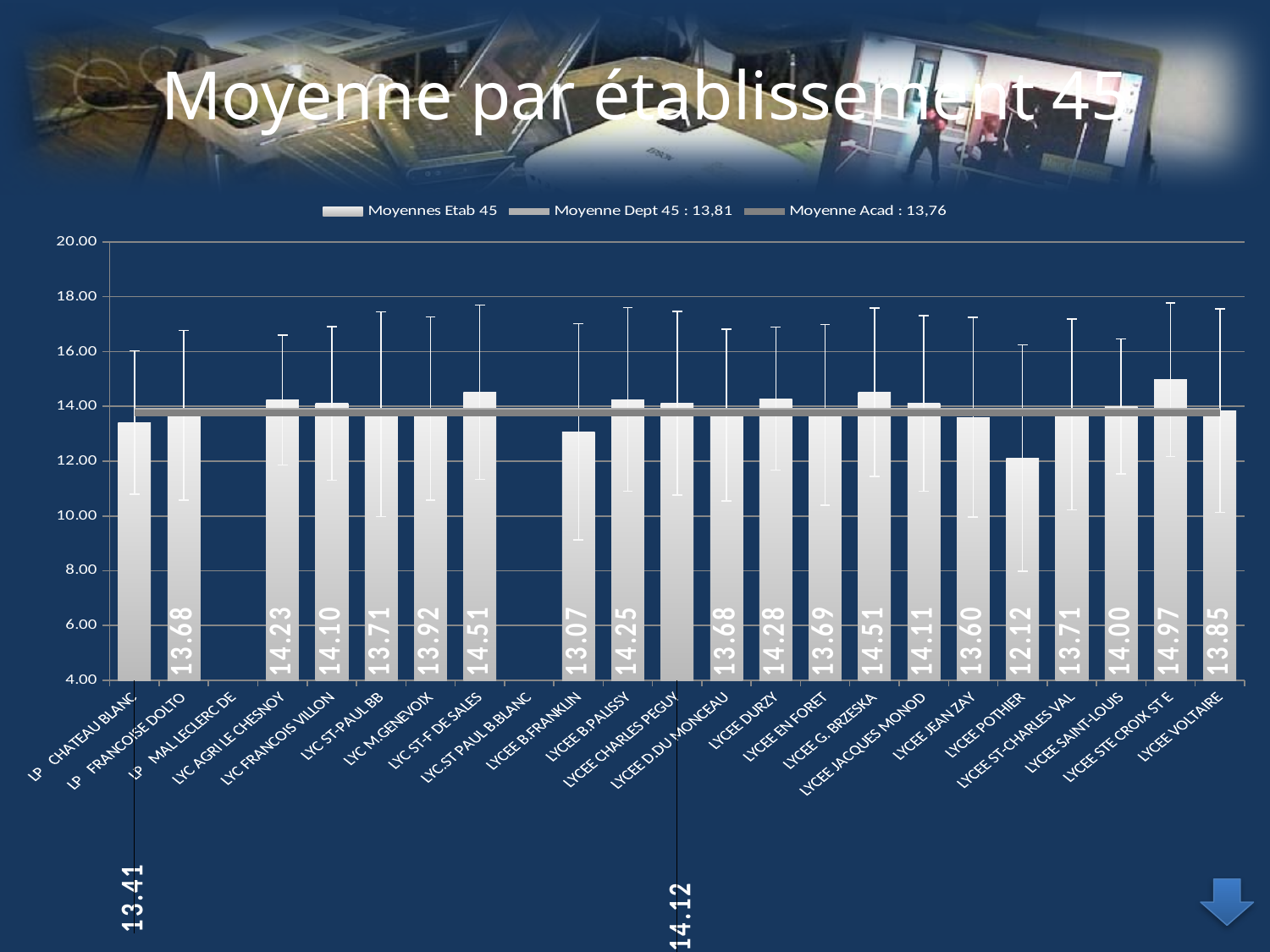
How many series does the legend list? 3 What value does the legend give for Moyenne Dept 45? 13,81 What type of chart is shown on the slide? bar chart Which establishment has the lowest average? LYCEE POTHIER What is the average for LYCEE STE CROIX ST E? 14.97 What is the average for LYCEE POTHIER? 12.12 Is the value for LYCEE POTHIER greater or less than 14.00? less Which establishment has the highest average? LYCEE STE CROIX ST E Which has a higher average, LYCEE VOLTAIRE or LYCEE POTHIER? LYCEE VOLTAIRE What is the title of the chart? Moyenne par établissement 45 What is the average for LP CHATEAU BLANC? 13.41 What is the difference between the highest average (LYCEE STE CROIX ST E) and the lowest average (LYCEE POTHIER)? 2.85